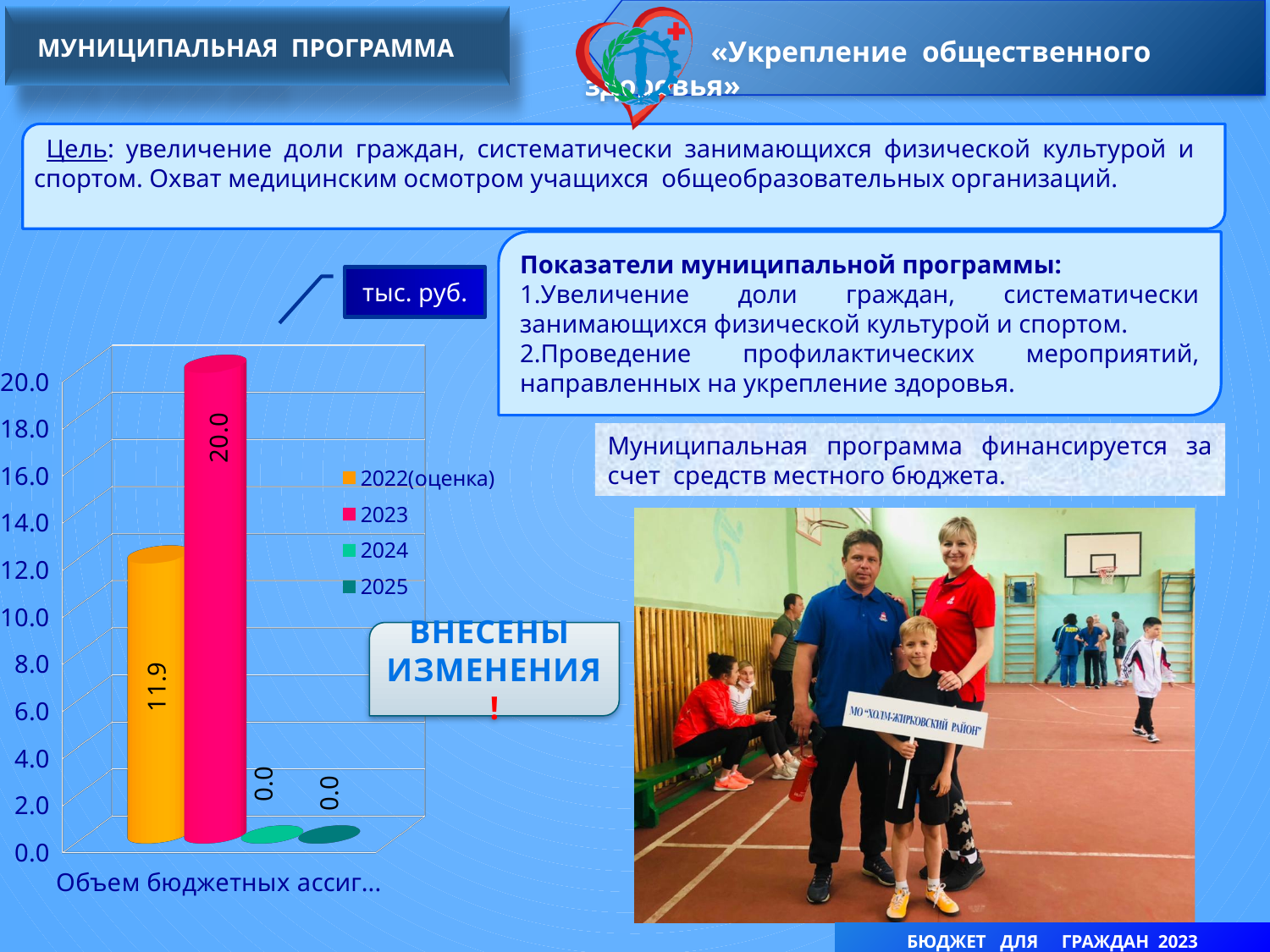
What kind of chart is shown on the slide? bar chart What is the value for 2023 on the chart? 20.0 Which series has the highest value on the chart? 2023 Is the value for 2022(оценка) greater or less than 10.0? greater What is the value for 2025 on the chart? 0.0 What is the value for 2024 on the chart? 0.0 How many series does the chart legend list? 4 What is the value for 2022(оценка) on the chart? 11.9 What is the difference between the 2023 value and the 2022(оценка) value? 8.1 What unit of measurement is shown in the box above the chart? тыс. руб. Which is larger, the value for 2022(оценка) or the value for 2023? 2023 What colour is the bar for 2023 in the chart? pink